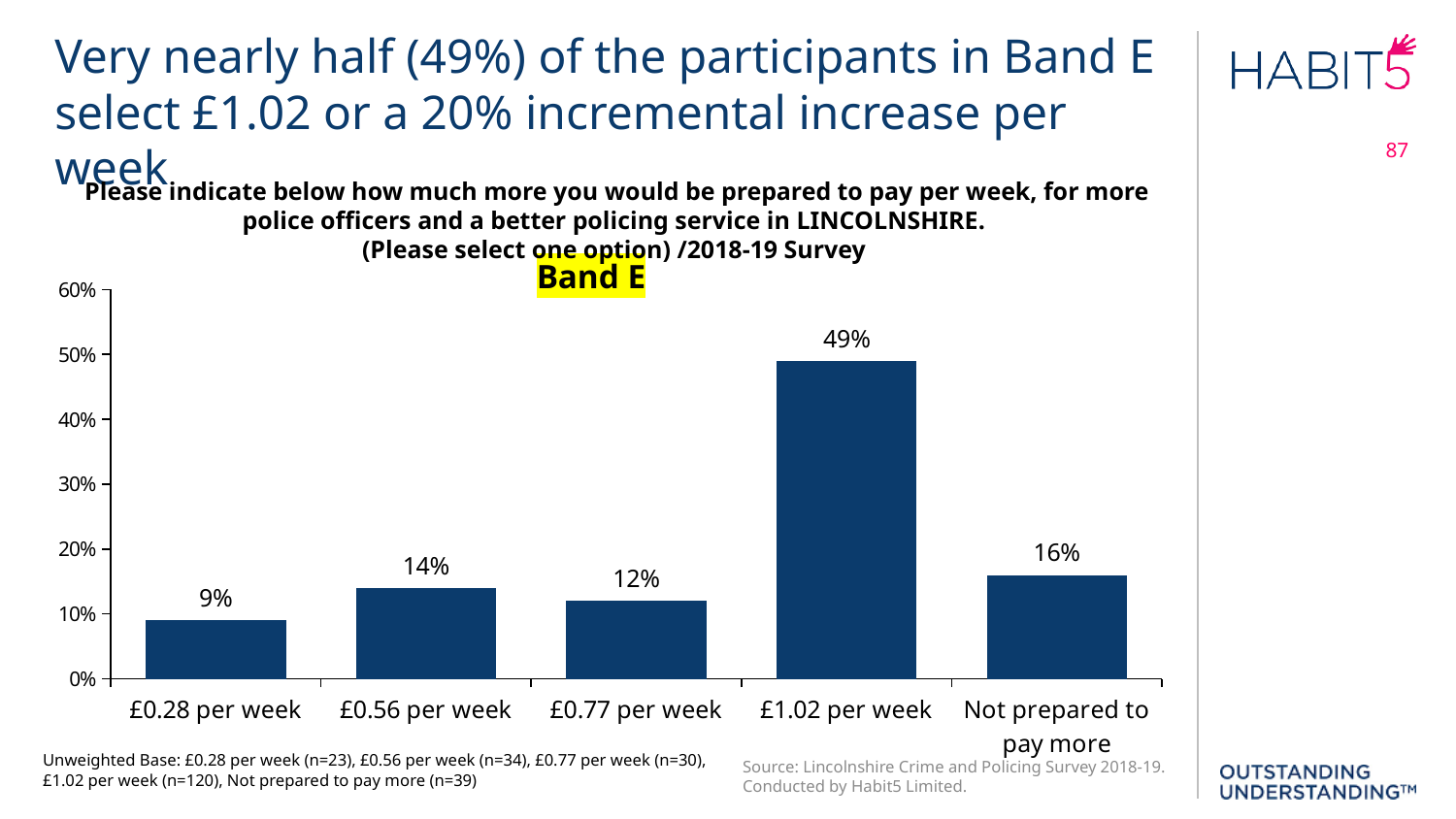
Which option has the highest percentage in the Band E chart? £1.02 per week What percentage of Band E participants selected £0.28 per week? 9% Is the value for £1.02 per week greater or less than 40%? greater What type of chart is shown on the slide? Bar chart Which is larger: the percentage for £0.56 per week or for £0.77 per week? £0.56 per week What is the difference in percentage points between £1.02 per week and Not prepared to pay more? 33 What is the difference in percentage points between £0.56 per week and £0.77 per week? 2 What is the highlighted label shown above the chart? Band E How many response options are shown on the x axis of the chart? 5 What percentage of Band E participants selected £1.02 per week? 49% Which option has the lowest percentage in the Band E chart? £0.28 per week What percentage of Band E participants were not prepared to pay more? 16%